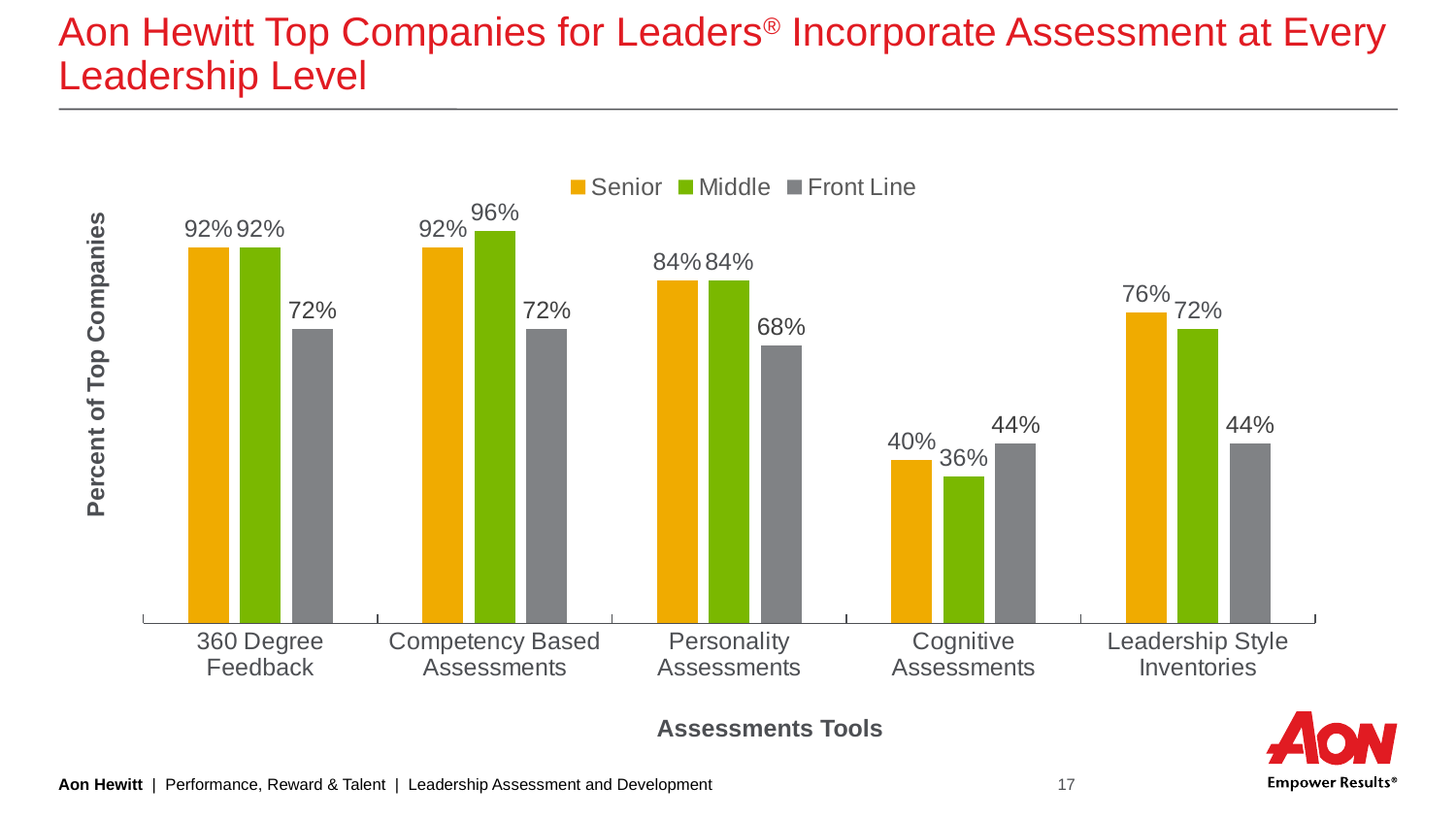
Which assessment tool has the highest Middle value? Competency Based Assessments What is the difference between the Senior and Front Line values for 360 Degree Feedback? 20% What kind of chart is shown on the slide? Bar chart What is the Front Line value for Personality Assessments? 68% What is the Middle value for Cognitive Assessments? 36% Which assessment tool has the lowest Senior value? Cognitive Assessments Which series is shown in grey in the legend? Front Line How many assessment tools are shown on the x axis? 5 What is the Senior value for Competency Based Assessments? 92% Which is larger for Leadership Style Inventories, the Senior value or the Middle value? Senior How many series does the legend list? 3 What is the label of the y axis? Percent of Top Companies